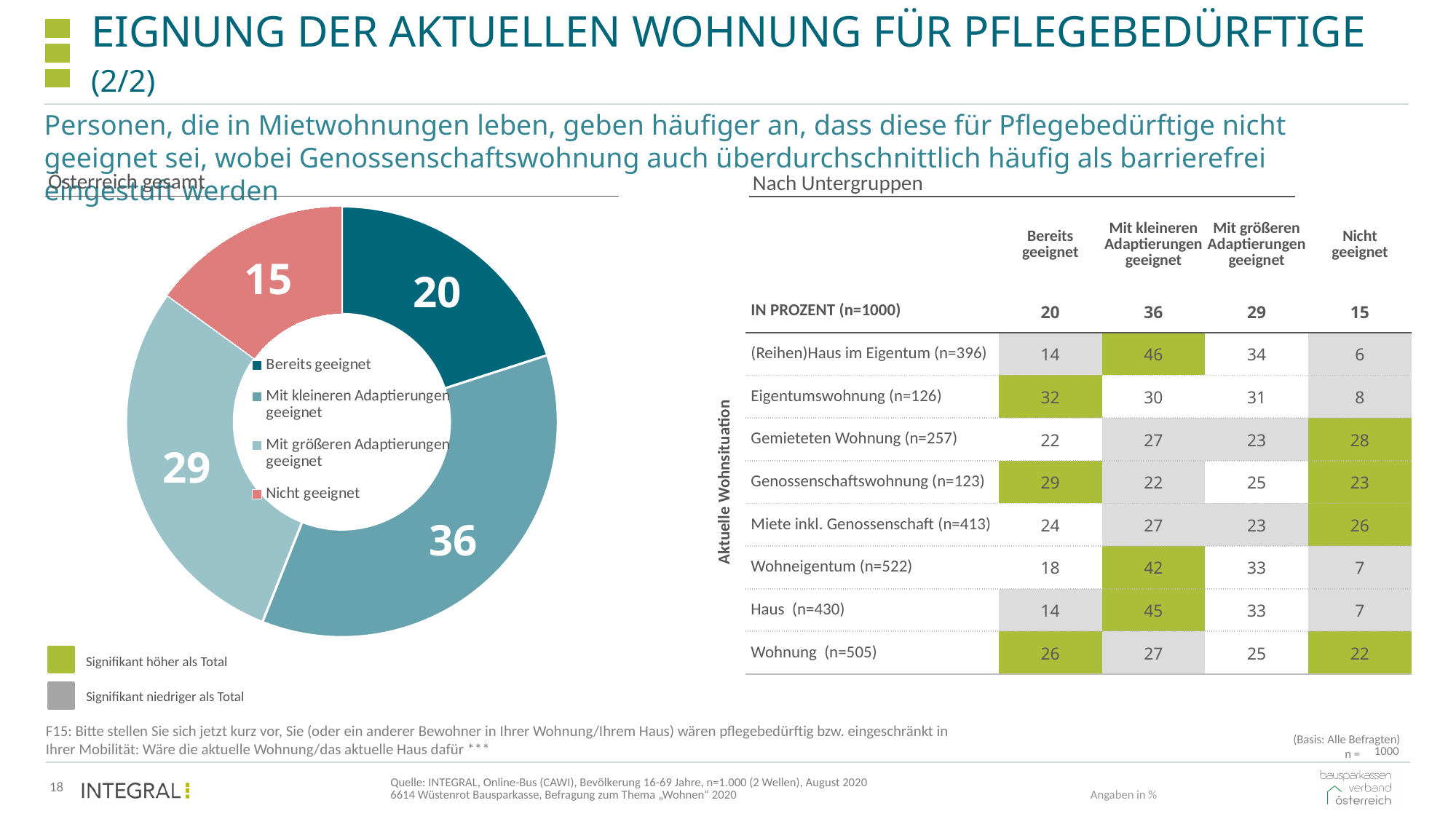
How many slices does the "Österreich gesamt" pie chart have? 4 In the "Österreich gesamt" pie chart, what is the value for "Mit kleineren Adaptierungen geeignet"? 36 In the "Österreich gesamt" pie chart, what is the difference between "Mit kleineren Adaptierungen geeignet" and "Mit größeren Adaptierungen geeignet"? 7 What kind of chart is shown under the heading "Österreich gesamt"? doughnut chart What share of the "Österreich gesamt" pie does "Nicht geeignet" represent? 15% Which category has the largest slice in the "Österreich gesamt" pie chart? Mit kleineren Adaptierungen geeignet In the "Österreich gesamt" pie chart, what is the value for "Nicht geeignet"? 15 Which category has the smallest slice in the "Österreich gesamt" pie chart? Nicht geeignet In the "Österreich gesamt" pie chart, what is the value for "Mit größeren Adaptierungen geeignet"? 29 In the "Österreich gesamt" pie chart, what is the value for "Bereits geeignet"? 20 In the "Österreich gesamt" pie chart, which is larger: "Bereits geeignet" or "Nicht geeignet"? Bereits geeignet What colour is the "Nicht geeignet" slice in the "Österreich gesamt" pie chart? red